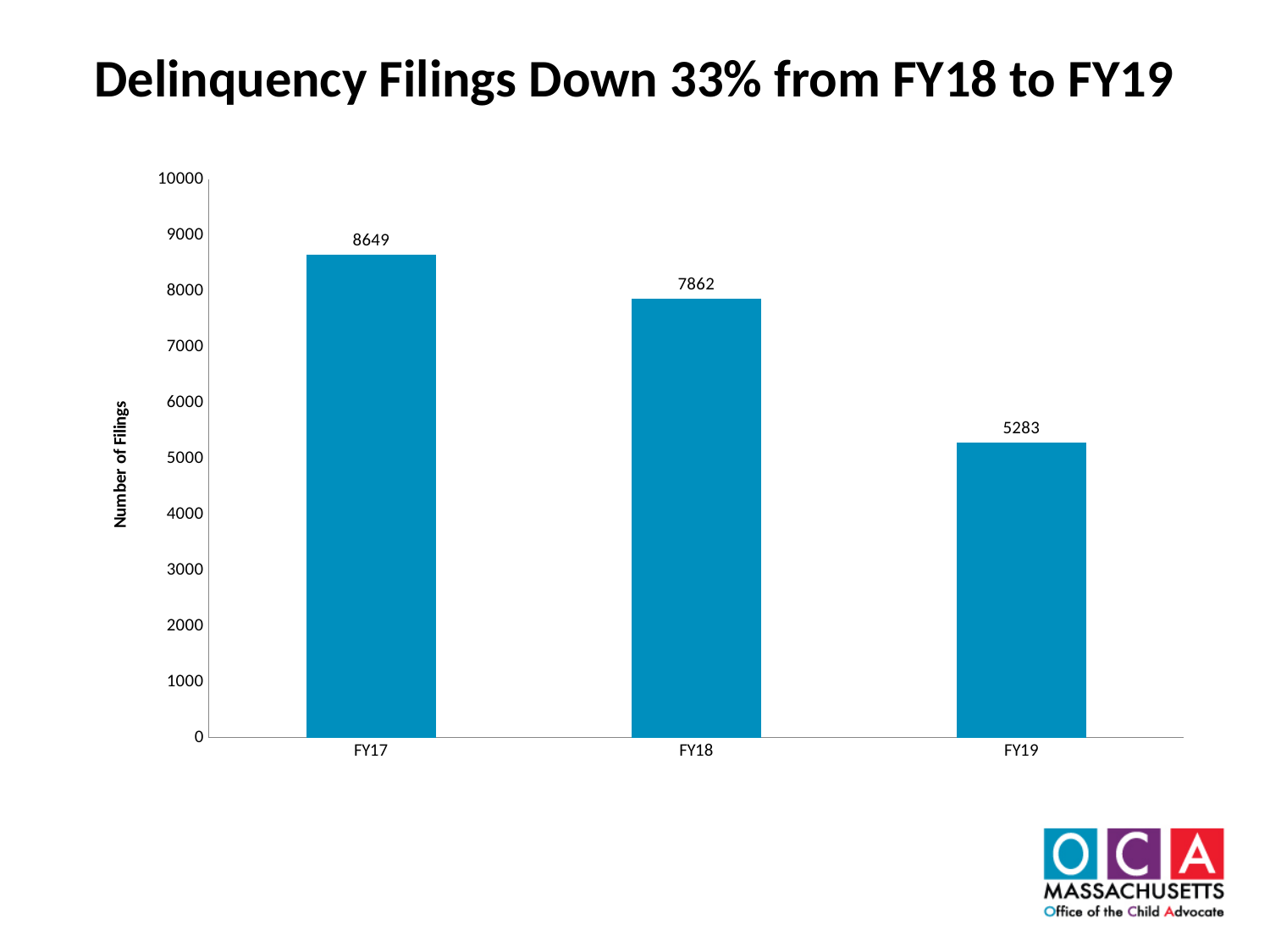
Which fiscal year has the lowest number of filings? FY19 Do the number of filings rise or fall from FY17 to FY19? fall What is the number of filings for FY18? 7862 What kind of chart is shown on the slide? bar chart What is the number of filings for FY19? 5283 Which has more filings, FY17 or FY19? FY17 How many fiscal years are shown on the chart? 3 Is the value for FY19 greater or less than 6000? less Which fiscal year has the highest number of filings? FY17 What is the number of filings for FY17? 8649 What is the difference in filings between FY18 and FY19? 2579 What is the difference in filings between FY17 and FY18? 787